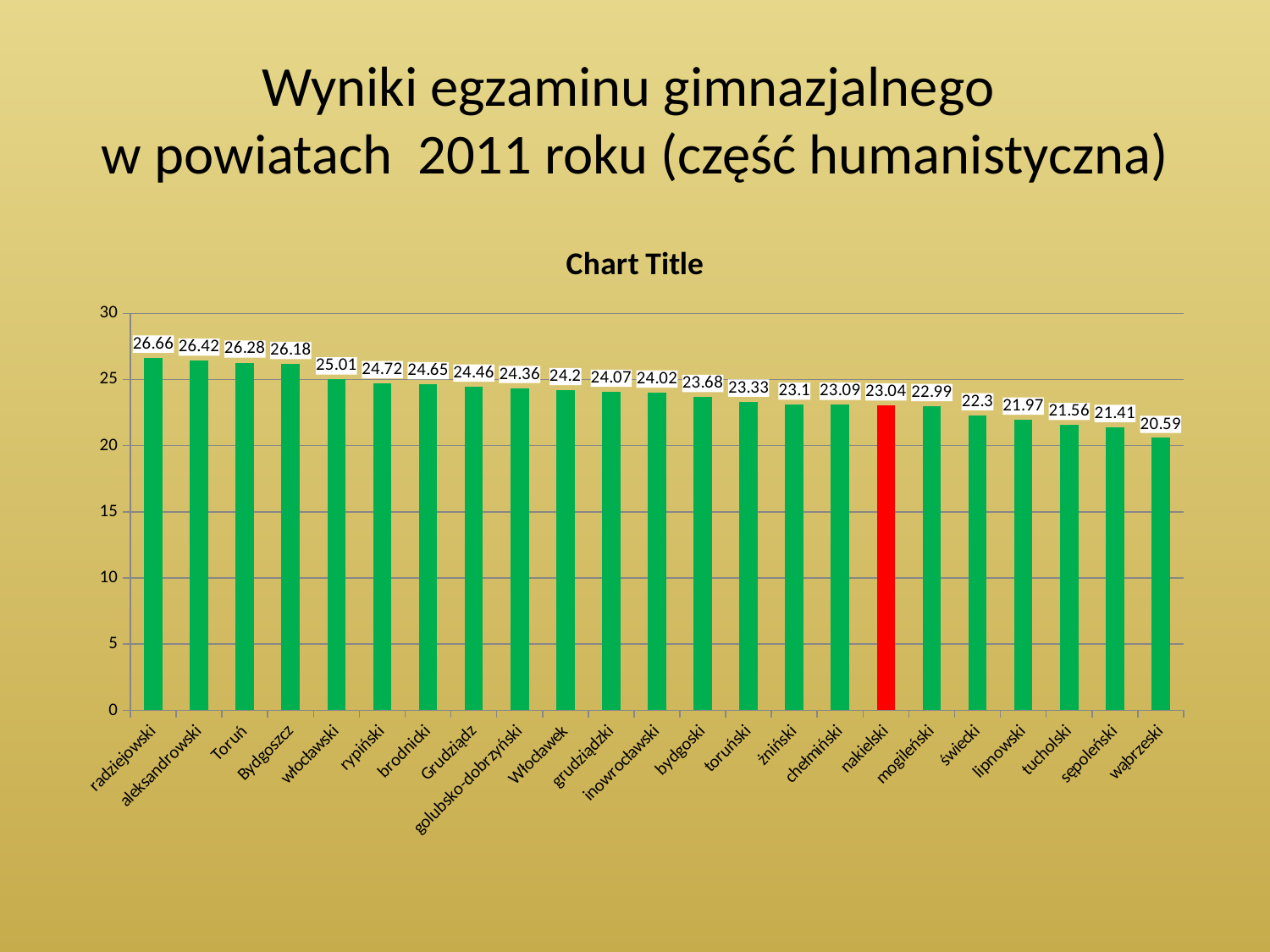
What kind of chart is shown? bar chart Which category has the lowest value? wąbrzeski What is the value for golubsko-dobrzyński? 24.36 How many categories are shown on the x axis? 23 Is the value for świecki greater or less than 25? less Do the values rise or fall from left to right along the x axis? fall What is the value for nakielski? 23.04 Which is larger, the value for włocławski or the value for Włocławek? włocławski Which category has the highest value? radziejowski Which category's bar is coloured red instead of green? nakielski What is the value for Toruń? 26.28 What is the difference between the values for radziejowski and wąbrzeski? 6.07